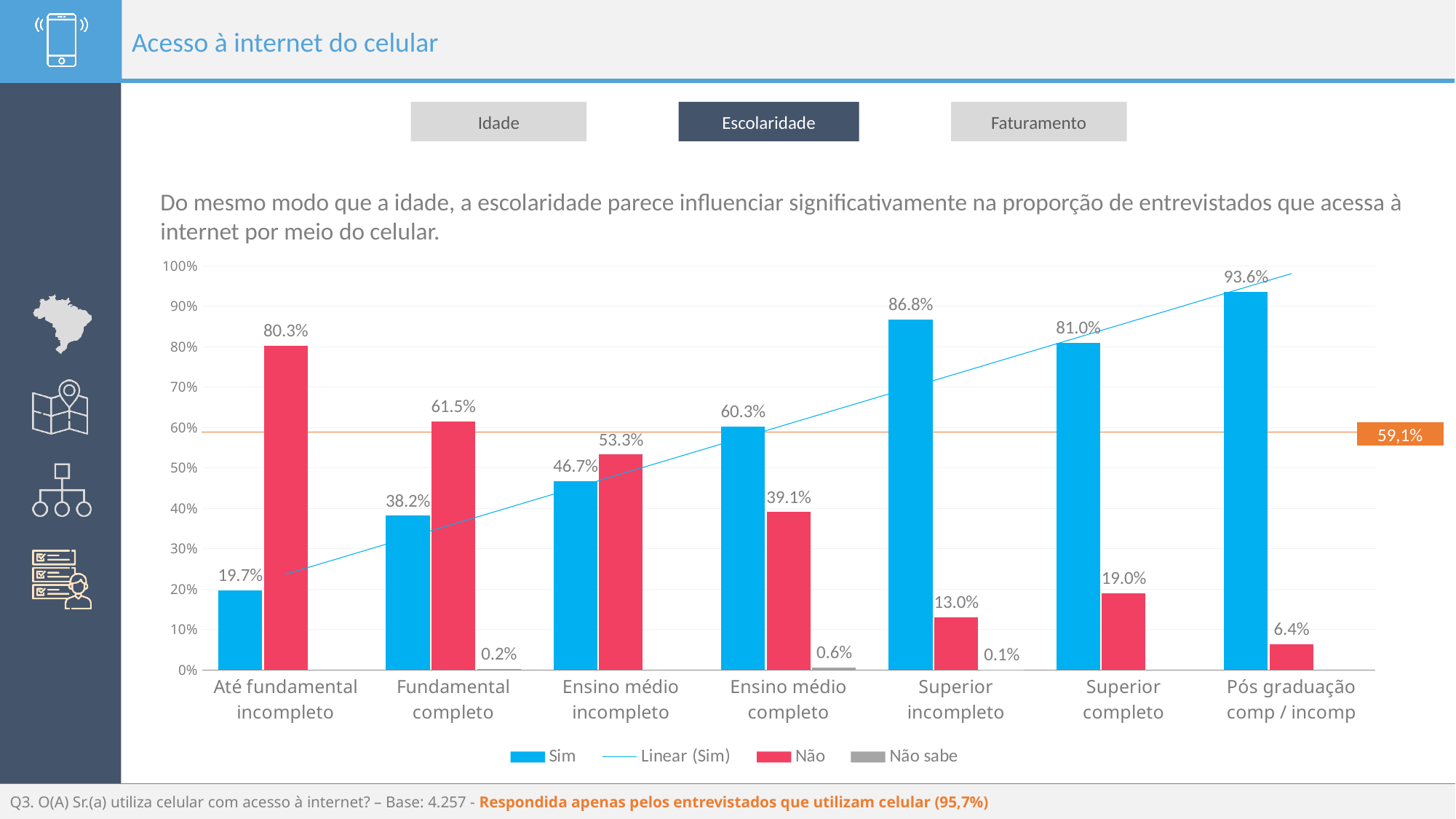
Which is larger: the "Sim" value for "Superior incompleto" or for "Superior completo"? Superior incompleto How many categories are shown on the x axis? 7 What value is shown in the orange label at the right of the chart? 59,1% What is the value of the "Sim" series for "Superior incompleto"? 86.8% What is the value of the "Não" series for "Até fundamental incompleto"? 80.3% What is the difference between the "Sim" and "Não" values for "Ensino médio completo"? 21.2 percentage points What is the value of the "Não sabe" series for "Ensino médio completo"? 0.6% What kind of chart is shown on the slide? Bar chart Which category has the highest value in the "Sim" series? Pós graduação comp / incomp Which category has the lowest value in the "Não" series? Pós graduação comp / incomp Which category has the lowest value in the "Sim" series? Até fundamental incompleto How many entries does the legend list? 4